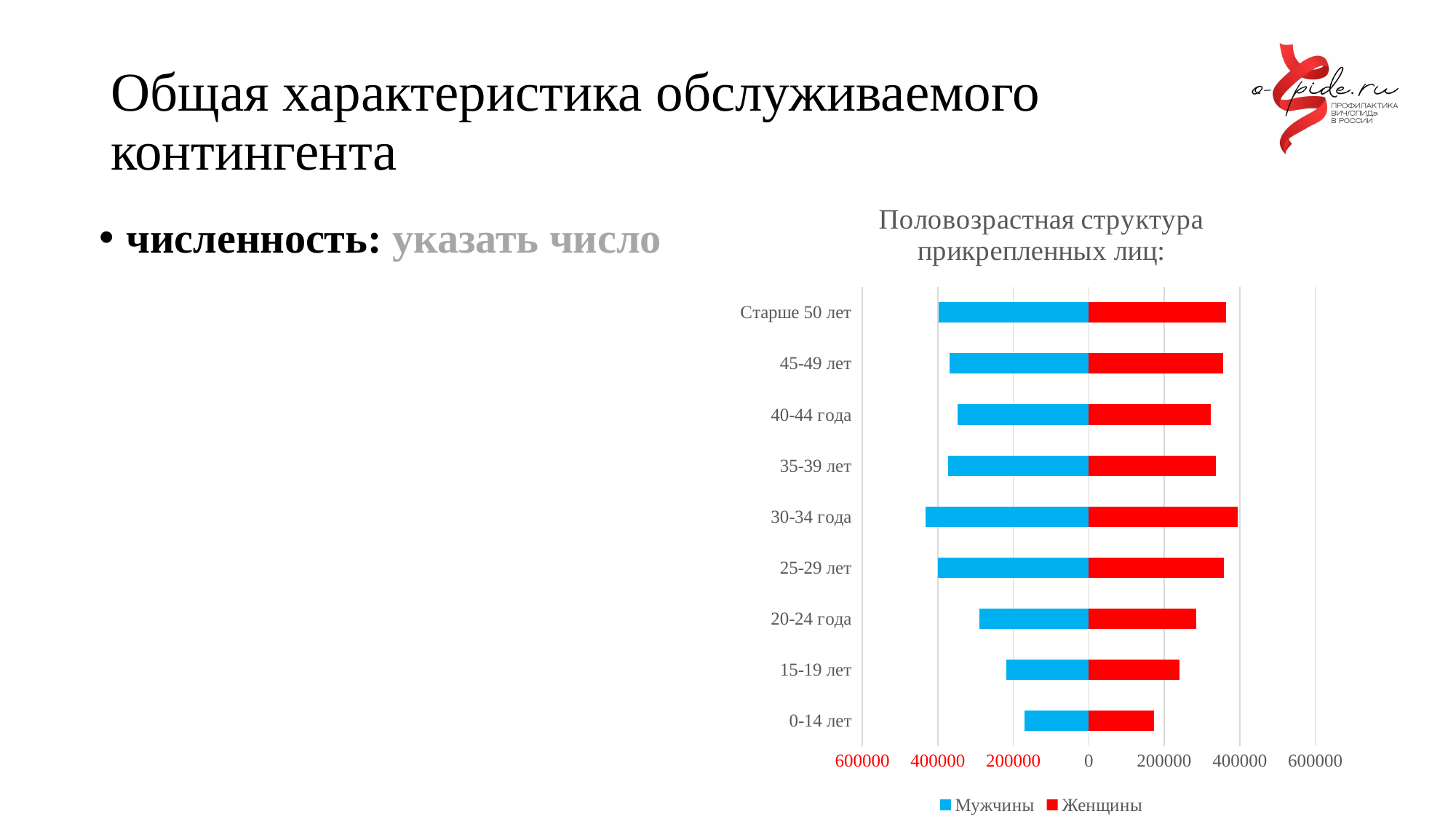
Which age group has the highest value for Мужчины? 30-34 года Is the value for Мужчины in the 0-14 лет group greater or less than 200000? less Is the value for Женщины in the 20-24 года group greater or less than 200000? greater How many age groups are shown on the chart? 9 Which age group has the lowest value for Мужчины? 0-14 лет Which age group has the highest value for Женщины? 30-34 года Is the value for Мужчины in the 30-34 года group greater or less than 400000? greater How many series does the chart legend list? 2 Which age group has the lowest value for Женщины? 0-14 лет What kind of chart is shown on the slide? bar chart Which colour represents the Женщины series in the chart? red Which is larger for Мужчины: the 30-34 года group or the 20-24 года group? 30-34 года